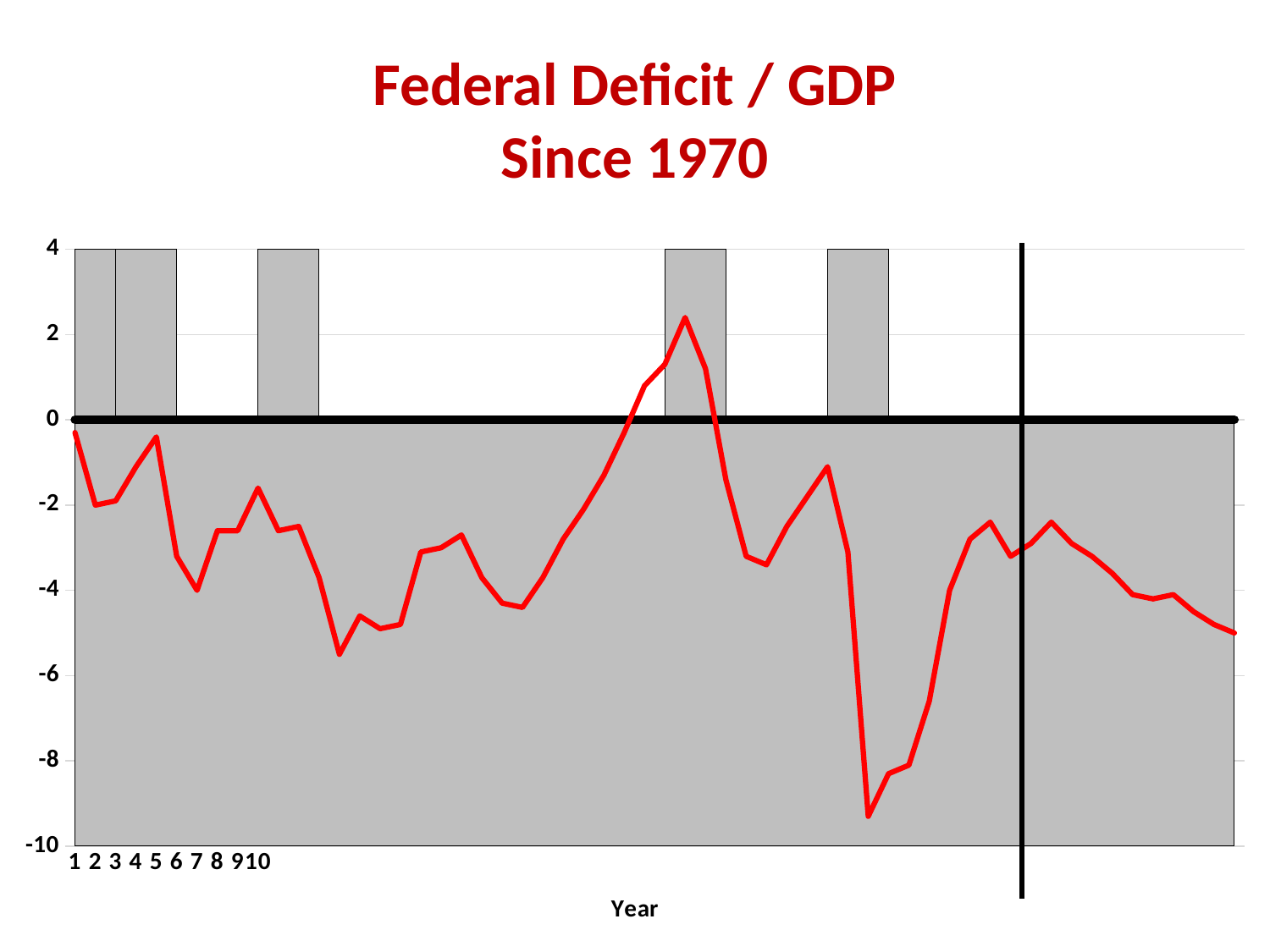
What is the label of the x axis? Year Is the value for year 5 greater or less than -2? greater Is the lowest value reached by the red line greater or less than -8? less Is the value for year 6 greater or less than -2? less What is the title of the chart? Federal Deficit / GDP Since 1970 Which is larger, the value for year 1 or the value for year 7? year 1 What kind of chart is shown on the slide? line chart What is the highest tick value shown on the y axis? 4